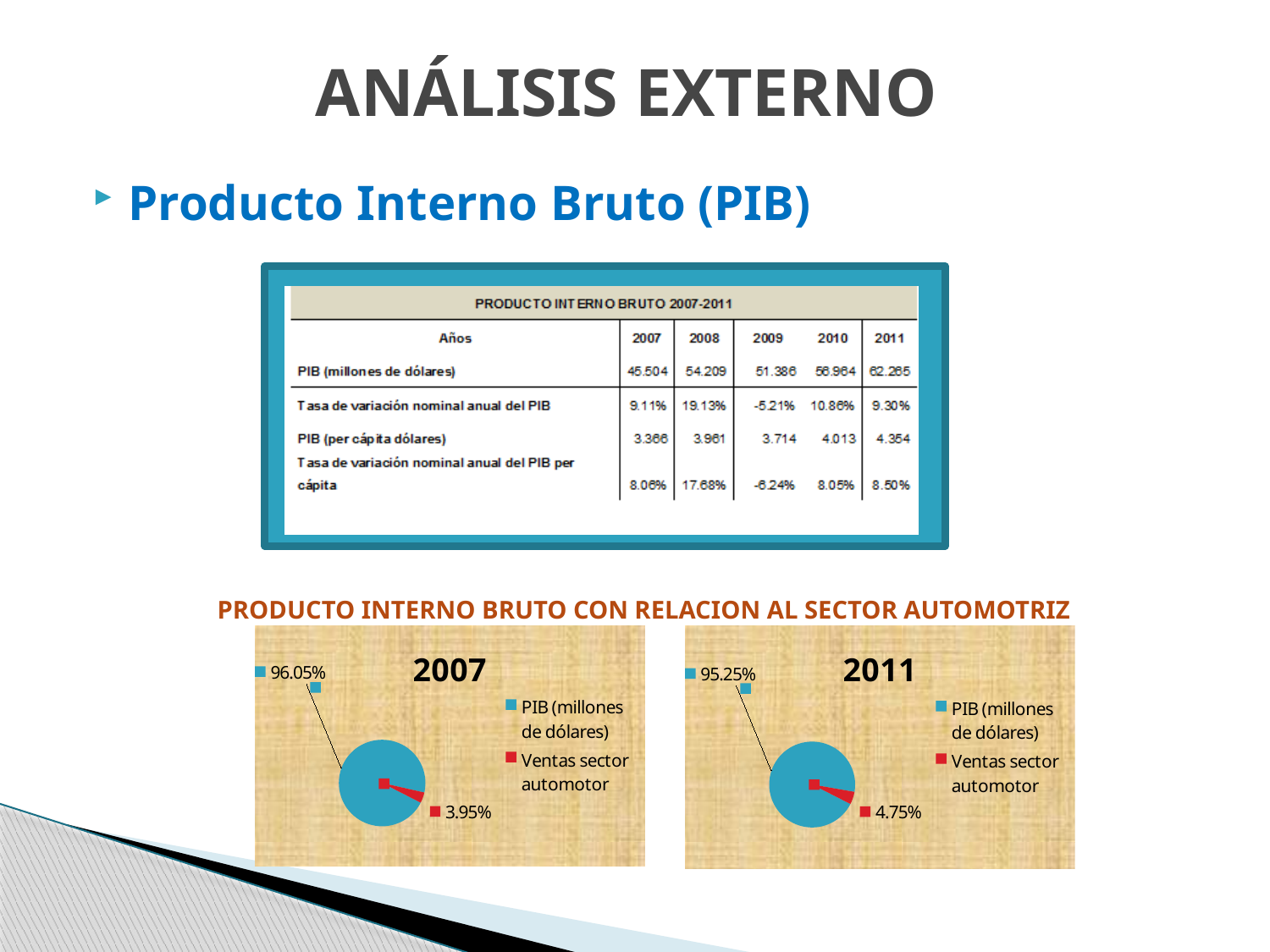
What type of chart is used for the 2007 and 2011 charts at the bottom of the slide? Pie chart In the 2007 pie chart, which slice is the smallest? Ventas sector automotor In the 2011 pie chart, which slice is the largest? PIB (millones de dólares) In the 2007 pie chart, what share is labelled for PIB (millones de dólares)? 96.05% What is the difference between the Ventas sector automotor share in the 2011 pie chart and in the 2007 pie chart? 0.80% How many slices does the 2007 pie chart have? 2 How many entries does the legend of the 2011 pie chart list? 2 In the 2007 pie chart, what share is labelled for Ventas sector automotor? 3.95% In the 2011 pie chart, what share is labelled for Ventas sector automotor? 4.75% Is the Ventas sector automotor share larger in the 2007 pie chart or the 2011 pie chart? 2011 What colour is the Ventas sector automotor slice in the 2011 pie chart? Red In the 2011 pie chart, what share is labelled for PIB (millones de dólares)? 95.25%